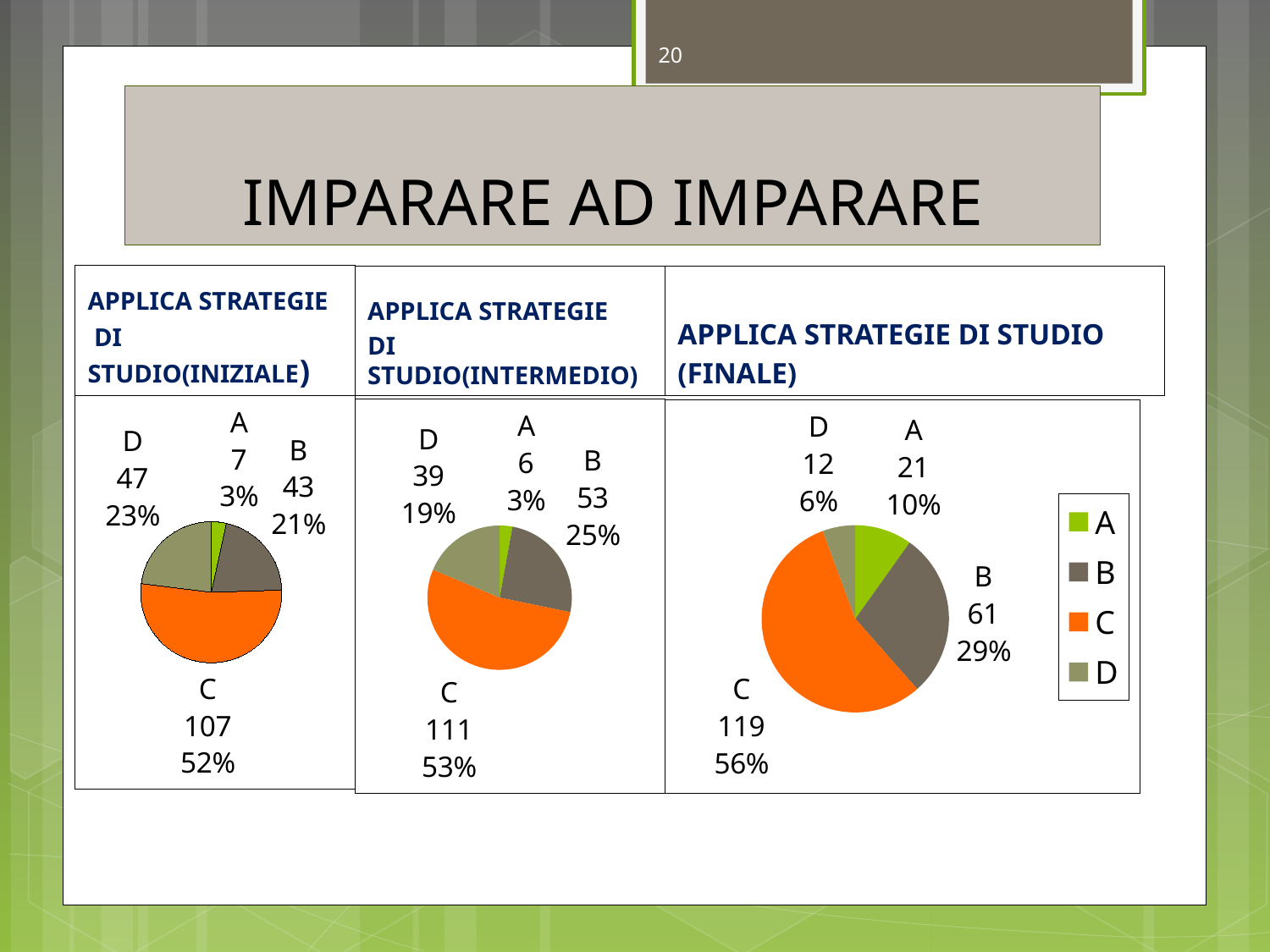
In the APPLICA STRATEGIE DI STUDIO(INTERMEDIO) chart, what is the difference between the values for C and B? 58 In the APPLICA STRATEGIE DI STUDIO (FINALE) chart, which is larger, the value for A or the value for D? A In the APPLICA STRATEGIE DI STUDIO(INIZIALE) chart, what percentage share does D have? 23% In the APPLICA STRATEGIE DI STUDIO (FINALE) chart, which category has the largest slice? C How many entries does the legend next to the APPLICA STRATEGIE DI STUDIO (FINALE) chart list? 4 What kind of chart is used in the APPLICA STRATEGIE DI STUDIO (FINALE) panel? Pie chart In the APPLICA STRATEGIE DI STUDIO(INIZIALE) chart, what is the value for C? 107 In the APPLICA STRATEGIE DI STUDIO(INTERMEDIO) chart, what percentage share does B have? 25% How many slices does the APPLICA STRATEGIE DI STUDIO(INIZIALE) pie chart have? 4 In the legend of the APPLICA STRATEGIE DI STUDIO (FINALE) chart, which colour represents C? Orange In the APPLICA STRATEGIE DI STUDIO (FINALE) chart, what is the value for D? 12 In the APPLICA STRATEGIE DI STUDIO(INIZIALE) chart, which category has the smallest slice? A